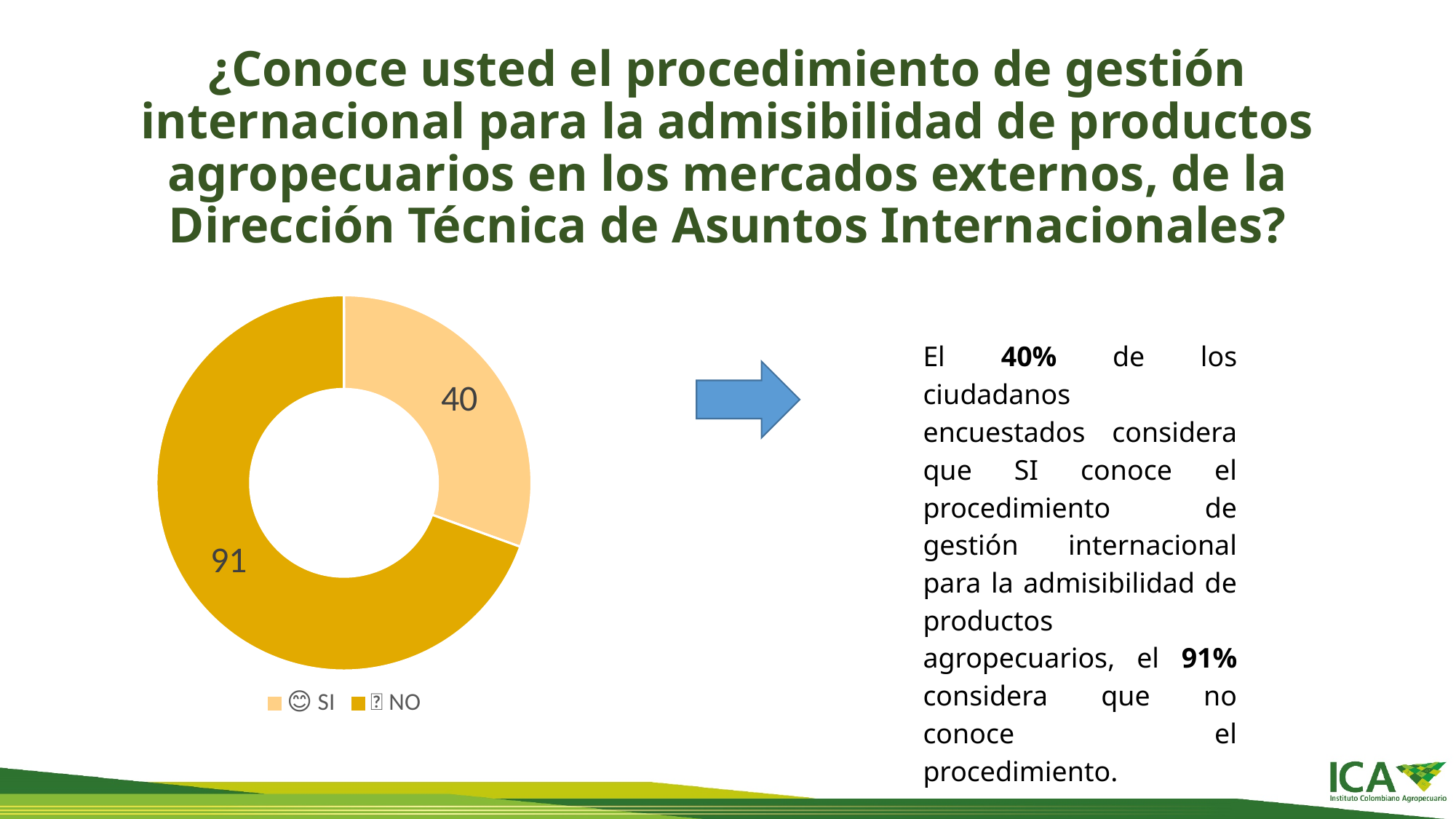
What is the total of the two values shown in the chart? 131 What value is shown for the SI slice of the doughnut chart? 40 Which is larger in the chart, the value for SI or the value for NO? NO Which category has the smallest slice in the chart? SI Which category has the largest slice in the chart? NO What value is shown for the NO slice of the doughnut chart? 91 Which colour represents the NO category in the chart? dark yellow (gold) What is the difference between the NO value and the SI value in the chart? 51 What kind of chart is shown on the slide? doughnut chart What are the two legend entries of the chart? SI and NO How many categories does the chart show? 2